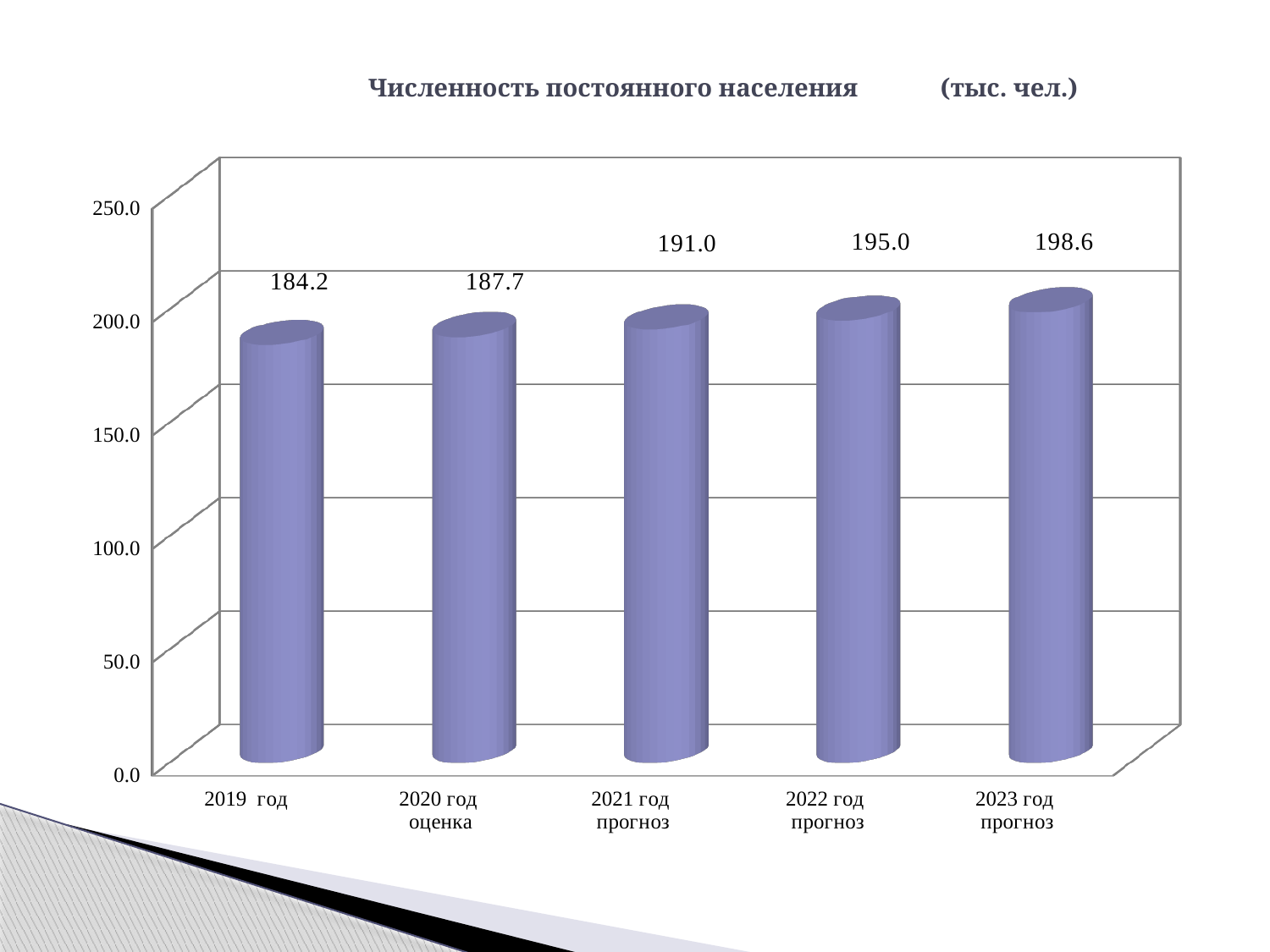
How many categories are shown on the x axis? 5 What kind of chart is shown on the slide? bar chart Is the value for 2021 год прогноз greater or less than 150.0? greater What is the value for 2019 год? 184.2 What is the difference between the values for 2023 год прогноз and 2019 год? 14.4 Which category has the lowest value? 2019 год Which is larger, the value for 2020 год оценка or the value for 2022 год прогноз? 2022 год прогноз Do the values rise or fall from 2019 год to 2023 год прогноз? rise What is the value for 2021 год прогноз? 191.0 Which category has the highest value? 2023 год прогноз What is the value for 2023 год прогноз? 198.6 What is the difference between the values for 2022 год прогноз and 2020 год оценка? 7.3